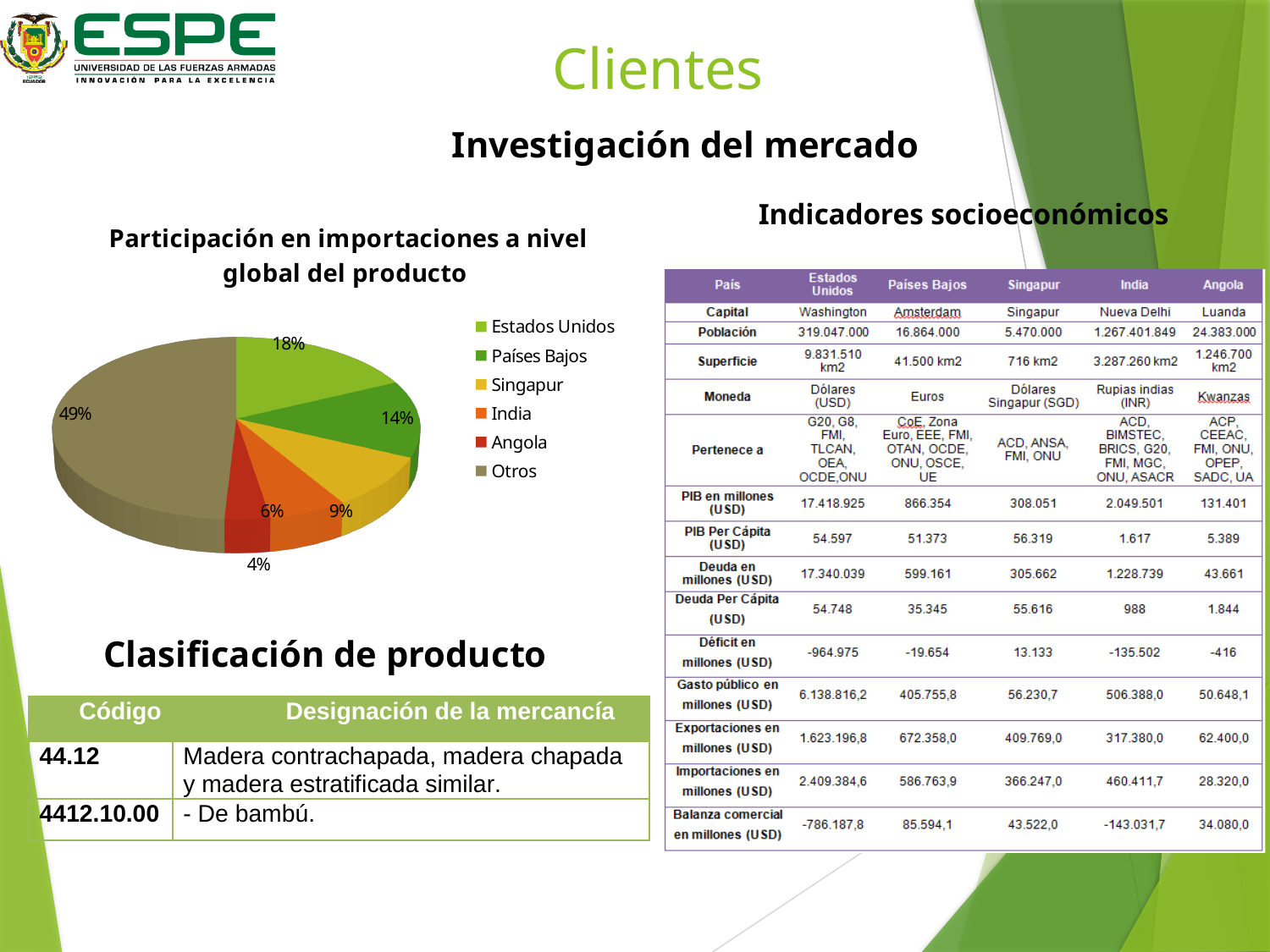
In the pie chart, what is the difference in percentage points between Estados Unidos and Países Bajos? 4 In the pie chart, what share of global imports corresponds to Otros? 49% How many categories does the legend of the pie chart list? 6 In the pie chart, what share of global imports corresponds to Angola? 4% What type of chart is used to show 'Participación en importaciones a nivel global del producto'? pie chart Which category has the smallest slice in the pie chart? Angola In the pie chart, what share of global imports corresponds to Singapur? 9% In the pie chart, what share of global imports corresponds to Estados Unidos? 18% In the pie chart, what share of global imports corresponds to Países Bajos? 14% In the pie chart, which has a larger share: Singapur or India? Singapur In the pie chart, what share of global imports corresponds to India? 6% Which category has the largest slice in the pie chart? Otros